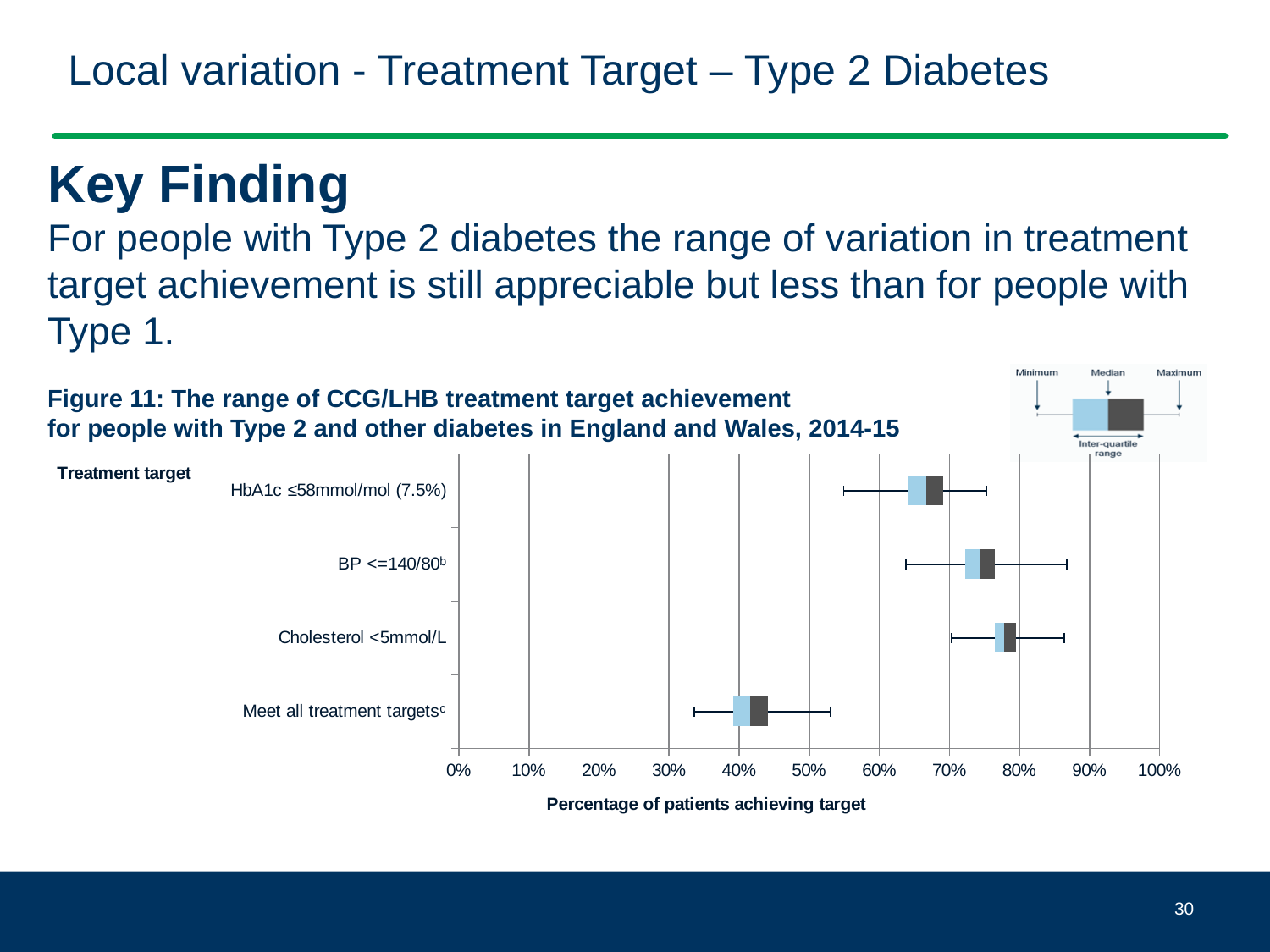
Is the maximum value for BP <=140/80 greater or less than 80%? greater What is the label of the horizontal axis in Figure 11? Percentage of patients achieving target Which treatment target has the lowest median percentage of patients achieving target? Meet all treatment targets Is the median value for 'Meet all treatment targets' greater or less than 50%? less Is the median value for HbA1c ≤58mmol/mol (7.5%) greater or less than 60%? greater How many treatment targets are plotted in Figure 11? 4 Which treatment target has the highest median percentage of patients achieving target? Cholesterol <5mmol/L Which has a higher median: BP <=140/80 or 'Meet all treatment targets'? BP <=140/80 What kind of chart is shown in Figure 11? Box plot (range chart with minimum, median, maximum and inter-quartile range) What does the shaded box in each row of Figure 11 represent, according to the key? Inter-quartile range